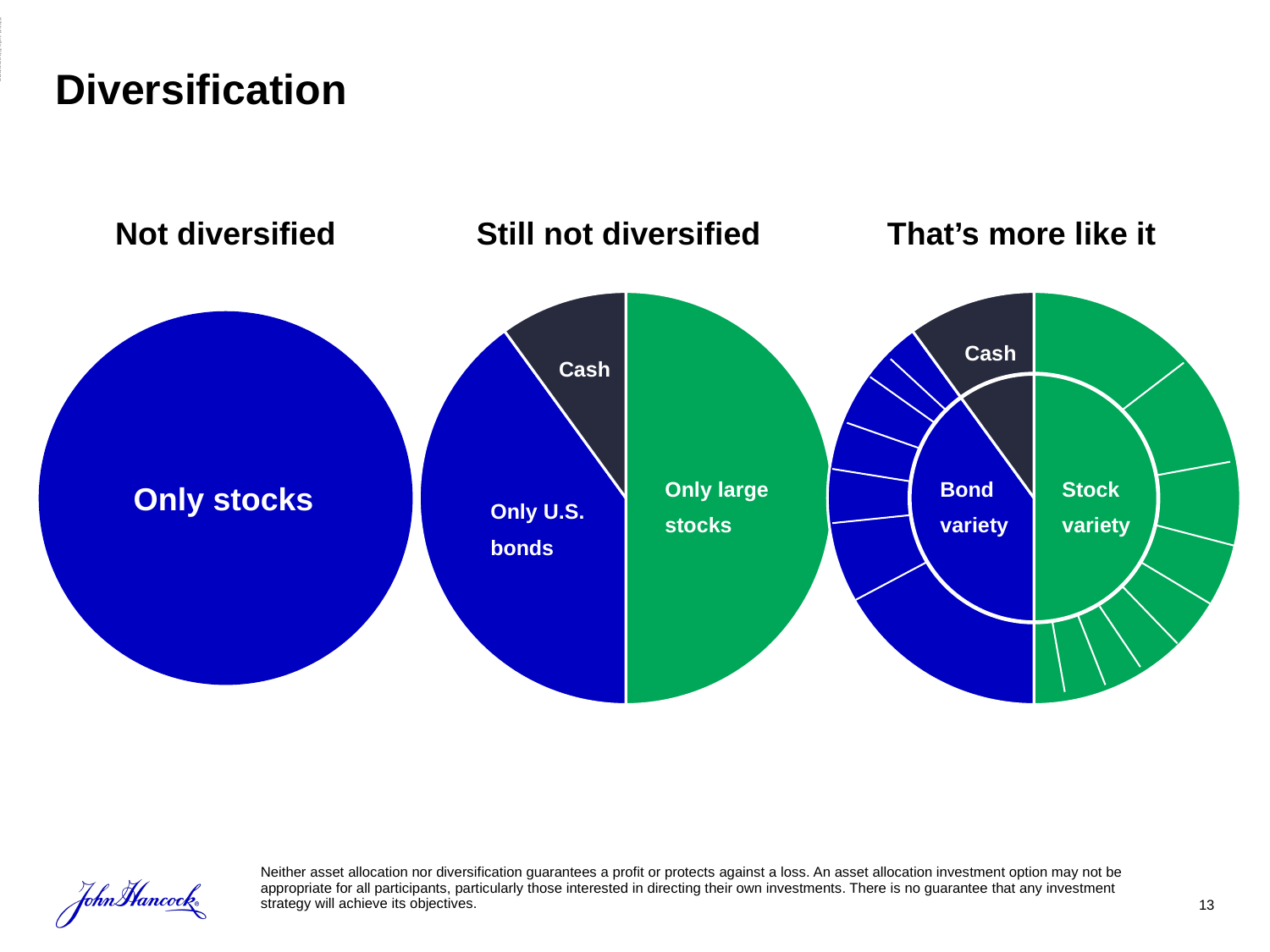
In the "That's more like it" chart, what are the three labelled slices? Stock variety, Bond variety, Cash In the "Still not diversified" chart, how many slices does the pie have? 3 In the "Still not diversified" chart, which slice is the smallest? Cash What is the heading above the rightmost pie chart? That's more like it In the "Not diversified" chart, what is the label of the single slice? Only stocks In the "Not diversified" chart, how many slices does the pie have? 1 What kind of chart is shown under the heading "Not diversified"? Pie chart In the "That's more like it" chart, which slice is larger, "Stock variety" or "Cash"? Stock variety In the "That's more like it" chart, which slice is the smallest? Cash In the "Still not diversified" chart, which slice is larger, "Only U.S. bonds" or "Cash"? Only U.S. bonds In the "Still not diversified" chart, what colour is the "Cash" slice? Dark navy In the "Still not diversified" chart, which slice is the largest? Only large stocks